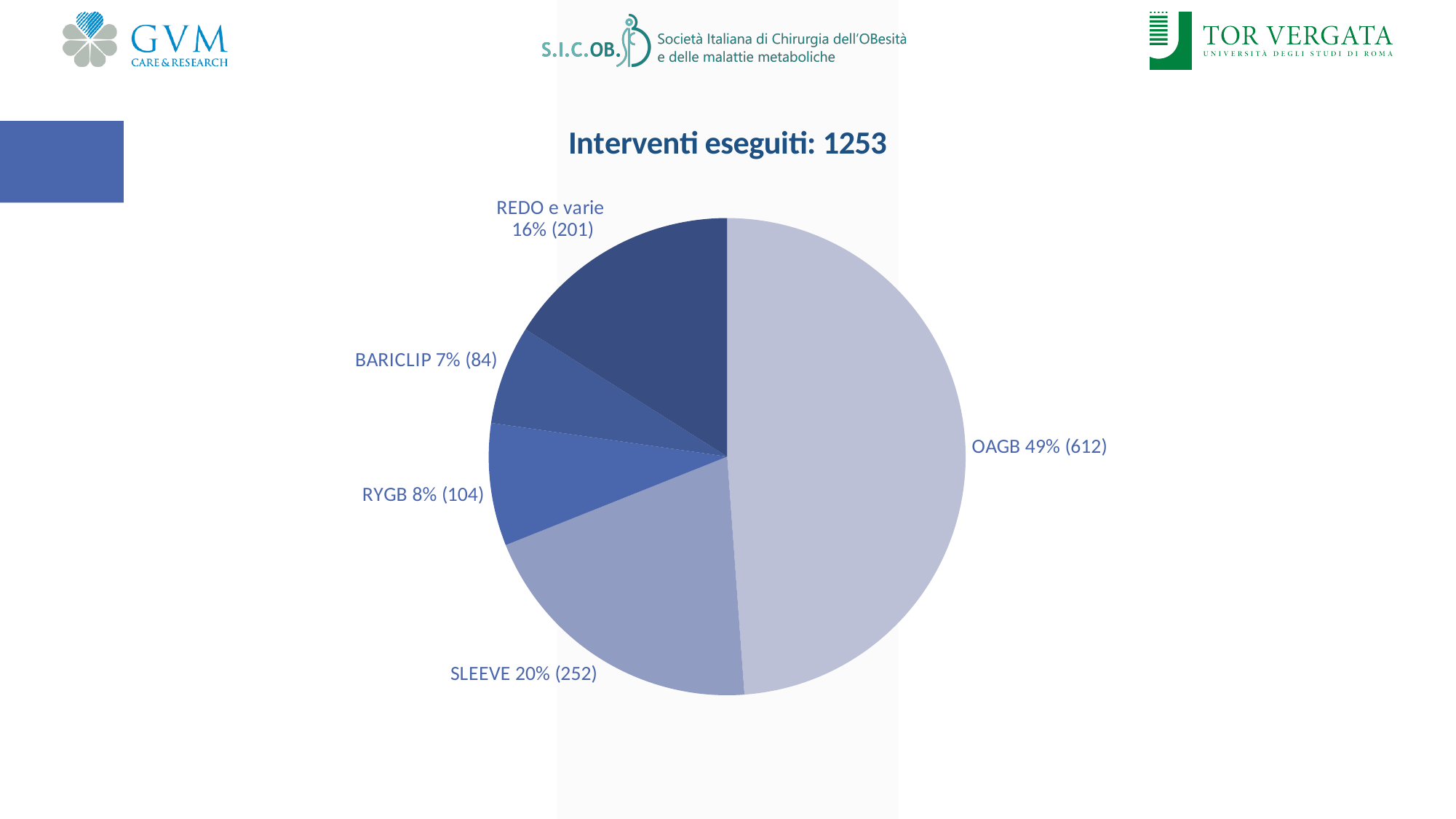
Which category has the smallest slice of the pie? BARICLIP How many interventions are shown for SLEEVE? 252 What kind of chart is shown on the slide? Pie chart What is the difference in number of interventions between OAGB and SLEEVE? 360 What share of the pie does OAGB represent? 49% What is the title of the chart? Interventi eseguiti: 1253 Which category has the largest slice of the pie? OAGB What percentage is shown for RYGB? 8% Which has more interventions, REDO e varie or RYGB? REDO e varie What is the total number of interventions shown in the chart title? 1253 How many interventions are shown for BARICLIP? 84 How many slices does the pie chart have? 5